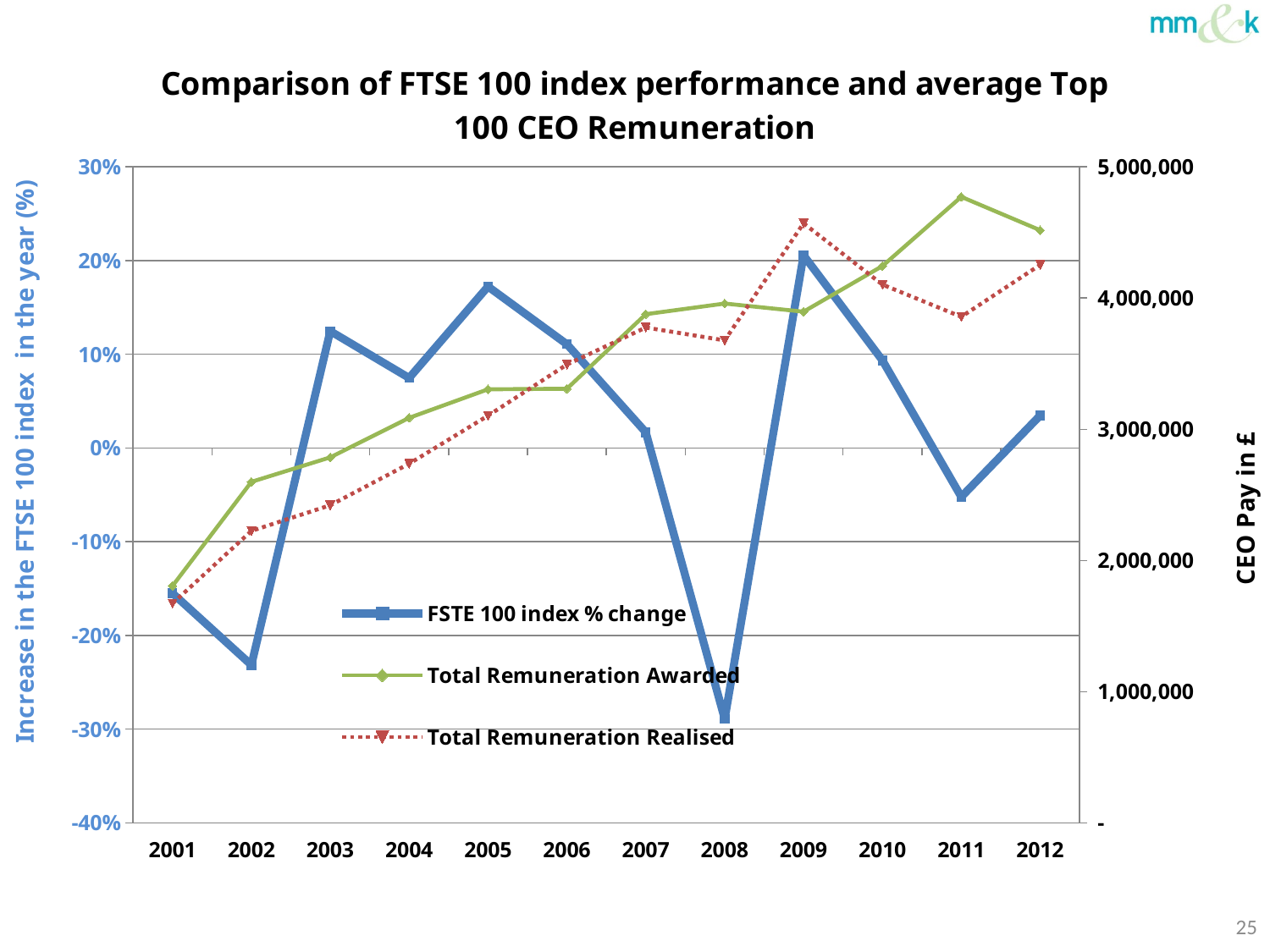
In which year is Total Remuneration Realised at its highest? 2009 In 2009, which is larger: Total Remuneration Awarded or Total Remuneration Realised? Total Remuneration Realised Is the Total Remuneration Awarded value for 2011 greater or less than 4,000,000? greater Is the FSTE 100 index % change for 2002 greater or less than -20%? less In which year is the FSTE 100 index % change at its lowest? 2008 How many series does the legend list? 3 In which year is the FSTE 100 index % change at its highest? 2009 How many years are plotted along the x axis? 12 What is the title of the right-hand vertical axis? CEO Pay in £ Is the Total Remuneration Realised value for 2001 greater or less than 2,000,000? less What kind of chart is shown on the slide? line chart In which year is Total Remuneration Awarded at its highest? 2011